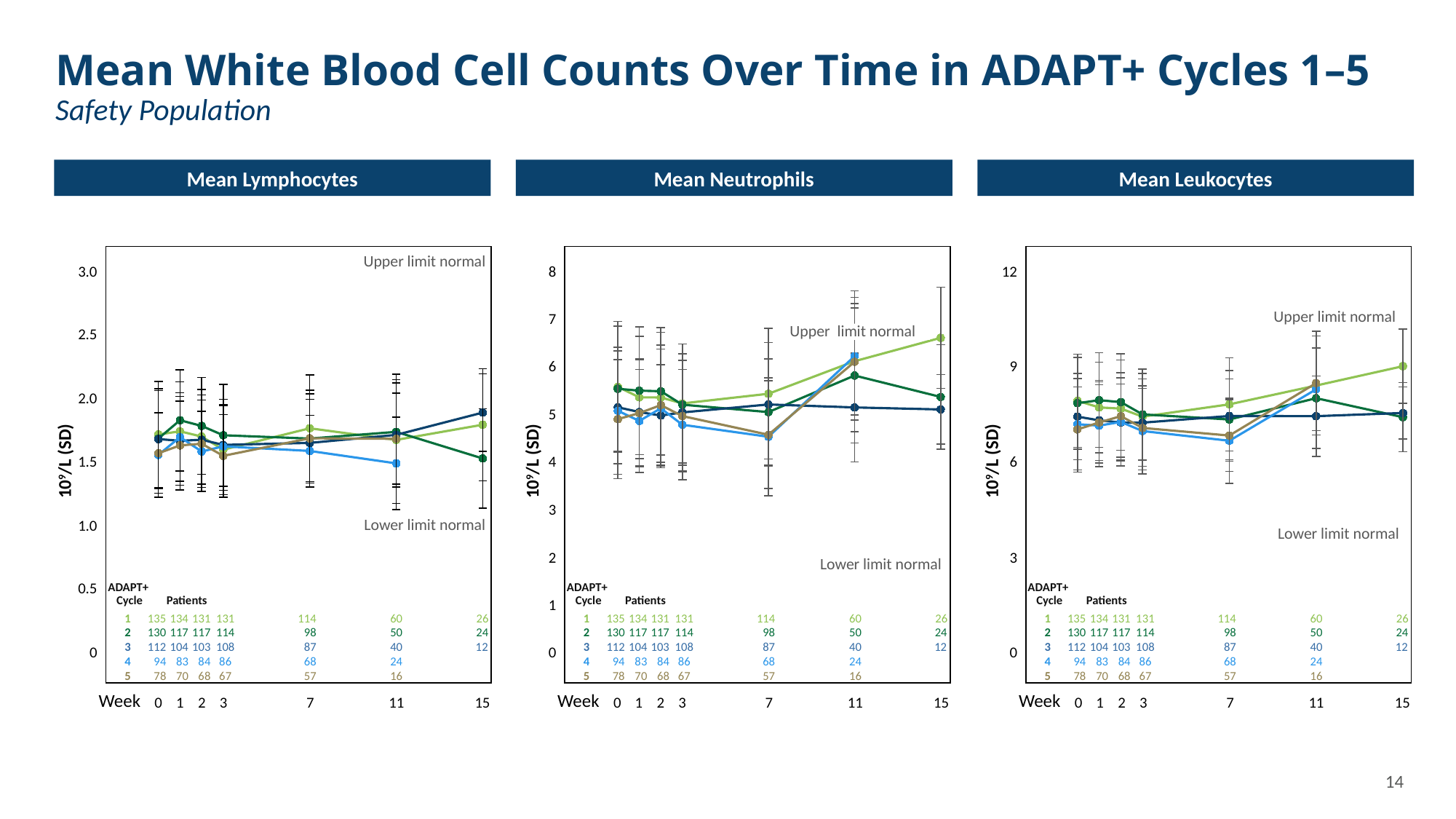
What is the y-axis label on the Mean Leukocytes chart? 10⁹/L (SD) In the Mean Lymphocytes chart, is the value for cycle 2 at week 15 greater or less than 2.0? less In the Mean Neutrophils chart, is the value for cycle 1 at week 15 greater or less than 6? greater In the Mean Lymphocytes chart, which cycle has the lowest value at week 15? Cycle 2 In the Mean Neutrophils chart, does the cycle 1 line rise or fall overall from week 0 to week 15? rise How many week time points are marked on the x axis of the Mean Neutrophils chart? 7 In the Mean Lymphocytes chart, how many patients are listed for cycle 5 at week 11? 16 What kind of chart is the Mean Lymphocytes chart? line chart In the Mean Leukocytes chart, is the value for cycle 4 at week 7 greater or less than 6? greater How many ADAPT+ cycles (series) are plotted in the Mean Leukocytes chart? 5 In the Mean Neutrophils chart, which cycle has the highest value at week 15? Cycle 1